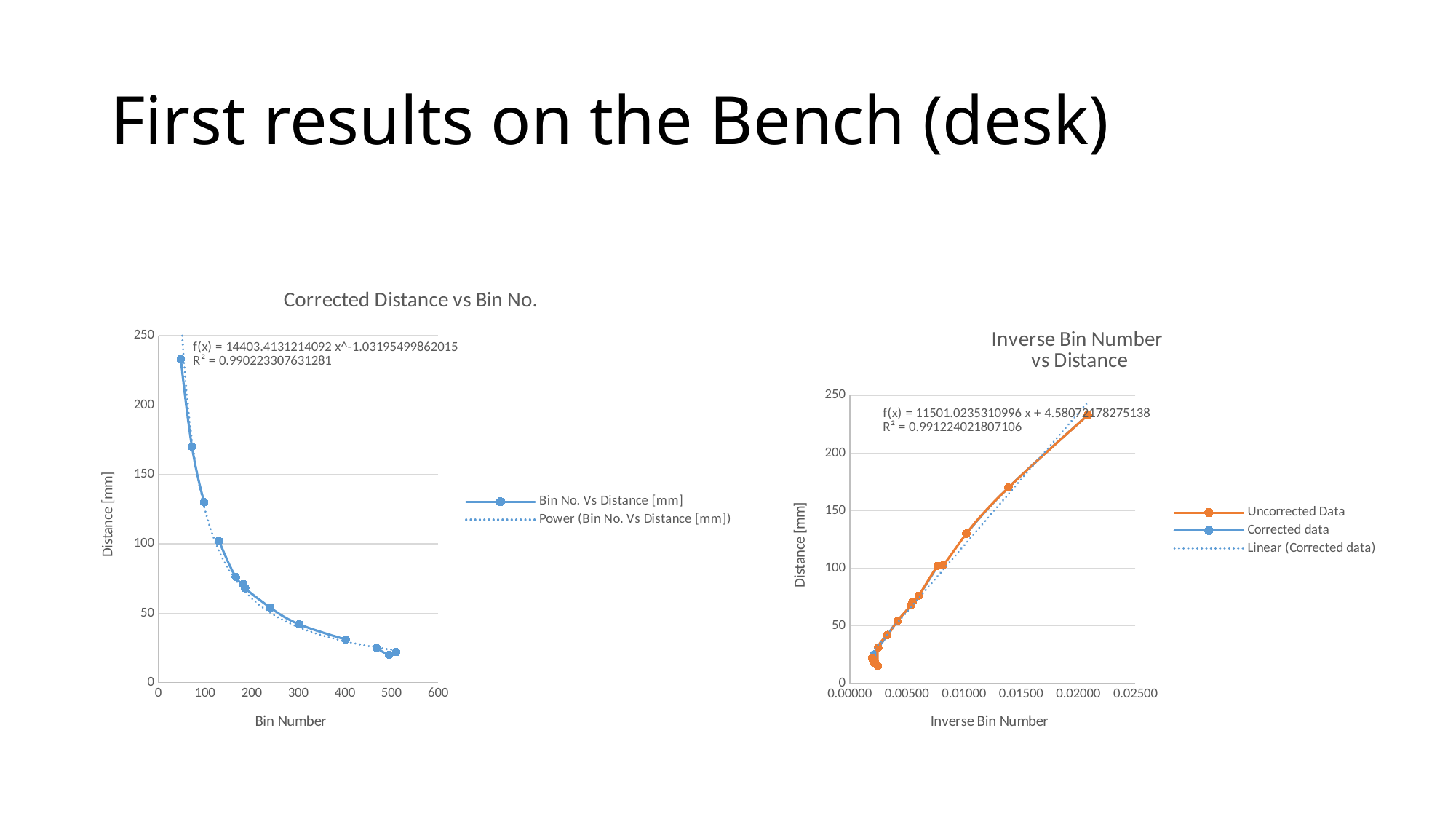
In the right chart "Inverse Bin Number vs Distance", is the distance for the Corrected data at inverse bin number 0.01000 greater or less than 100? greater In the left chart "Corrected Distance vs Bin No.", is the distance at bin number 400 greater or less than 50? less What is the R² value shown on the left chart "Corrected Distance vs Bin No."? 0.990223307631281 What is the R² value shown on the right chart "Inverse Bin Number vs Distance"? 0.991224021807106 How many series does the legend of the left chart "Corrected Distance vs Bin No." list? 2 What kind of chart is the left chart titled "Corrected Distance vs Bin No."? Line chart with markers (scatter) How many series does the legend of the right chart "Inverse Bin Number vs Distance" list? 3 In the right chart "Inverse Bin Number vs Distance", is the distance at the highest inverse bin number (about 0.021) greater or less than 200? greater In the right chart "Inverse Bin Number vs Distance", does the distance rise or fall as the inverse bin number increases? Rise What is the x-axis label of the left chart "Corrected Distance vs Bin No."? Bin Number In the left chart "Corrected Distance vs Bin No.", does the distance rise or fall as the bin number increases? Fall